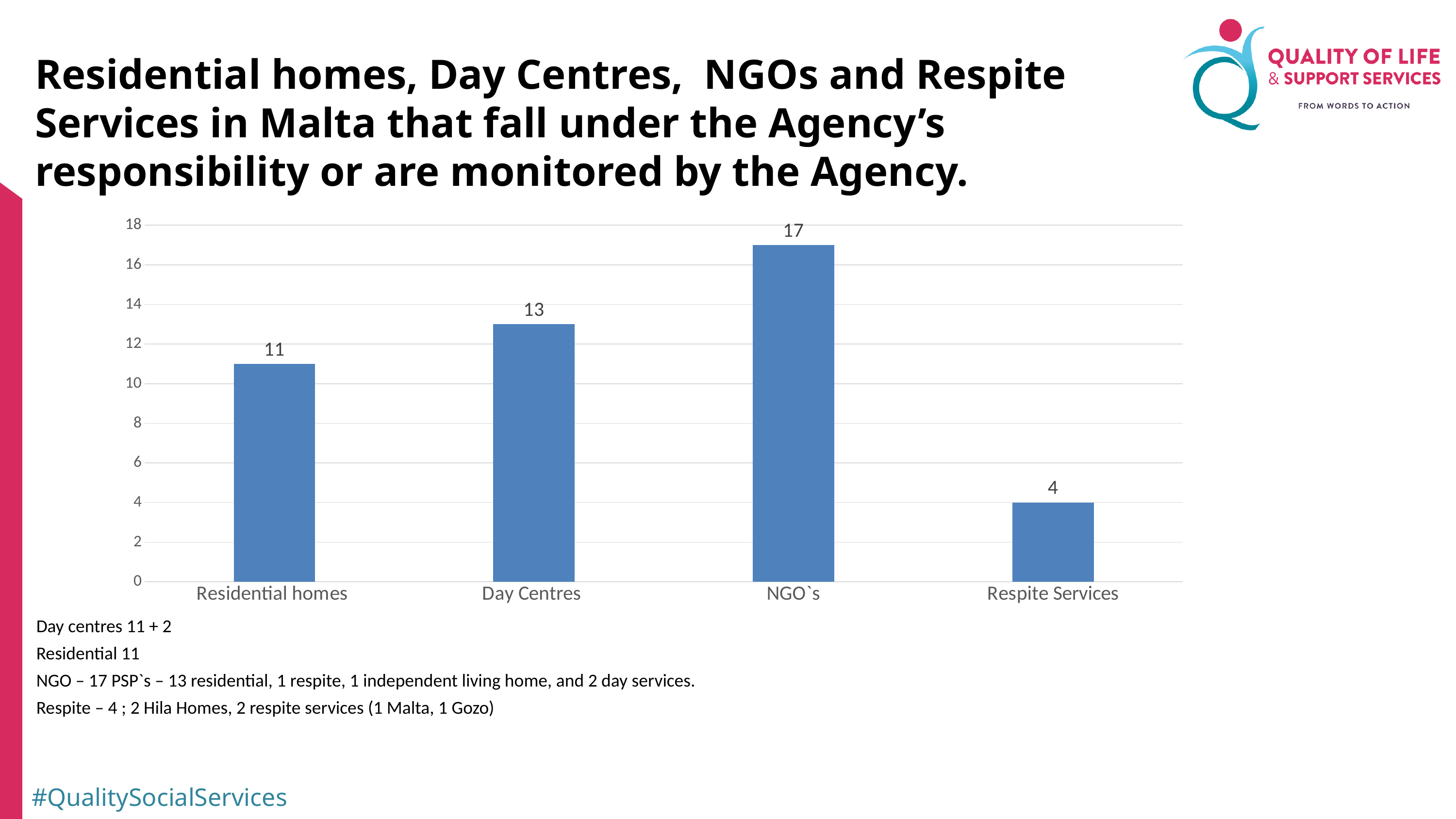
Is the value for NGO`s greater or less than 16? greater What is the difference between the values for NGO`s and Day Centres? 4 What is the difference between the values for Residential homes and Respite Services? 7 What kind of chart is shown on the slide? Bar chart What is the value for NGO`s? 17 What is the value for Day Centres? 13 How many categories are shown on the chart? 4 What is the value for Respite Services? 4 Which is larger, the value for Day Centres or the value for Residential homes? Day Centres What is the value for Residential homes? 11 Which category has the lowest value? Respite Services Which category has the highest value? NGO`s